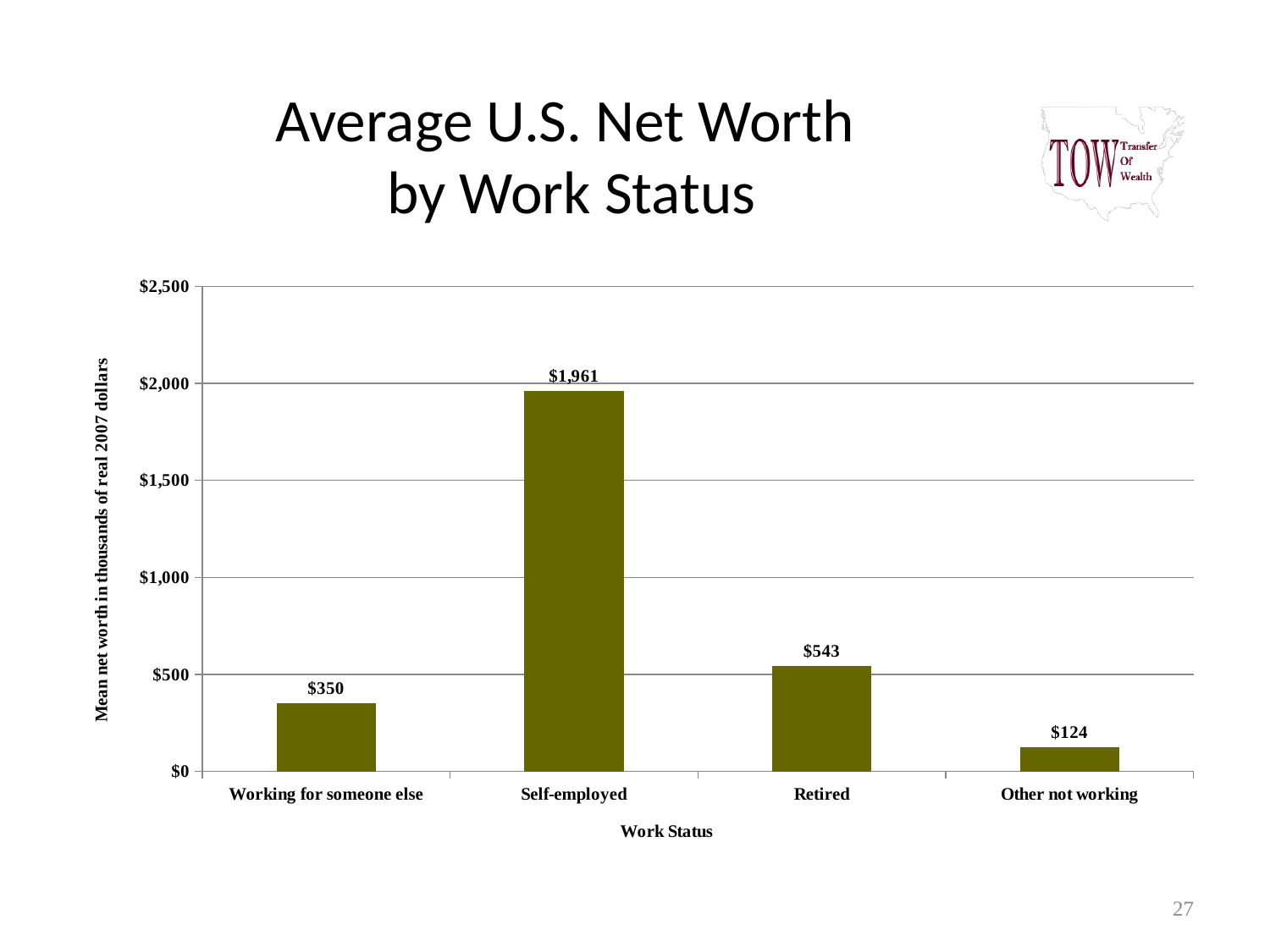
Is the value for Self-employed greater or less than $1,500? greater What kind of chart is shown on the slide? Bar chart Which has a larger mean net worth, Retired or Working for someone else? Retired What is the mean net worth for Retired? $543 How many work status categories are shown in the chart? 4 What is the difference between the mean net worth for Self-employed and Retired? $1,418 Which work status has the highest mean net worth? Self-employed Which work status has the lowest mean net worth? Other not working What is the mean net worth for Other not working? $124 What is the mean net worth for Self-employed? $1,961 What is the difference between the mean net worth for Retired and Working for someone else? $193 What is the mean net worth for Working for someone else? $350